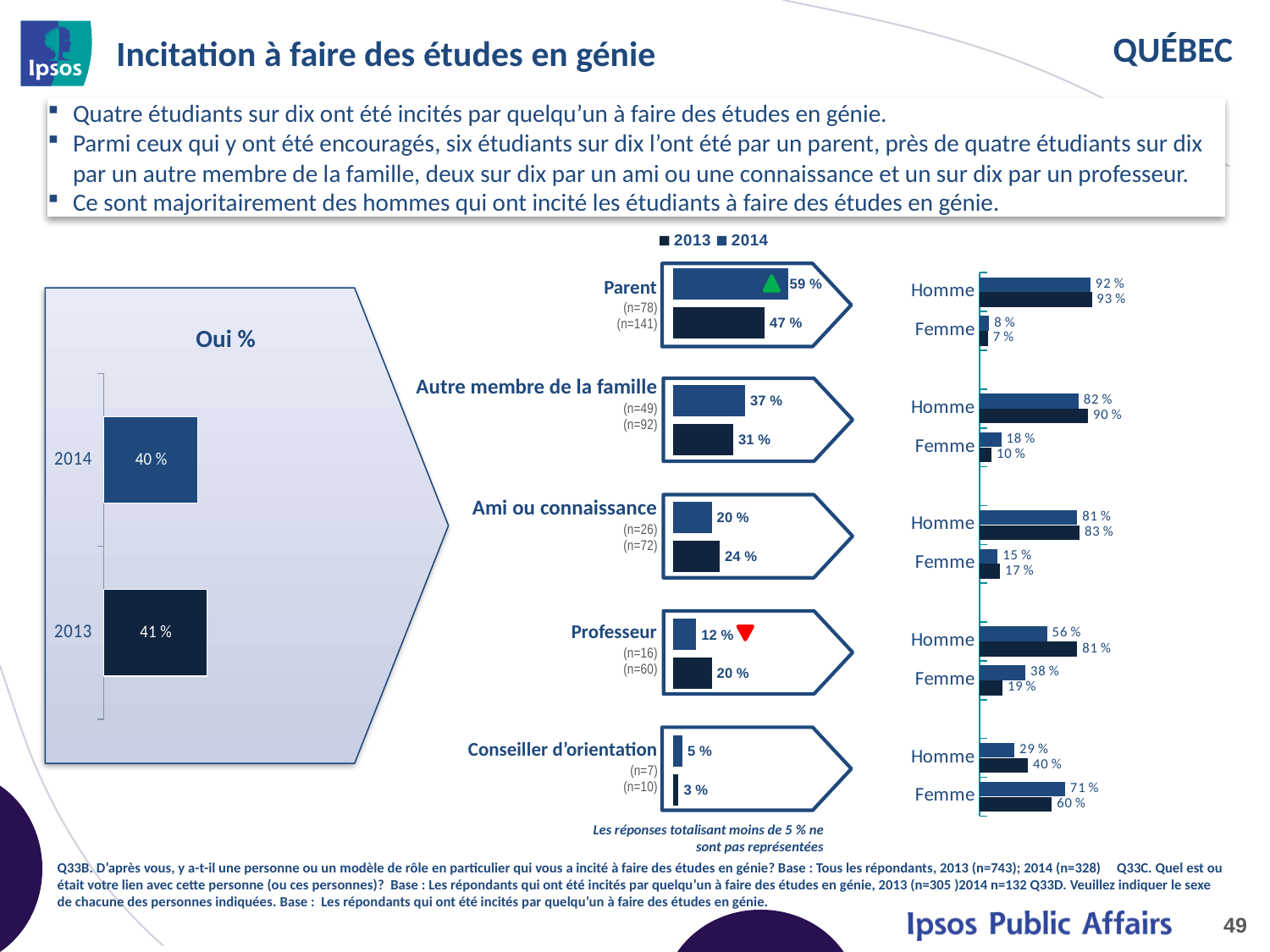
What kind of chart is the 'Oui %' chart on the left? Bar chart In the 'Oui %' chart on the left, which year has the larger value, 2013 or 2014? 2013 How many relationship categories are shown in the middle chart? 5 In the middle chart of relationship categories, which category has the highest value? Parent In the 'Oui %' chart on the left, what is the difference between the 2013 and 2014 values? 1 % How many series does the legend above the middle chart list? 2 What are the two entries in the legend above the middle chart? 2013 and 2014 In the 'Oui %' chart on the left, what is the value for 2013? 41 % In the 'Oui %' chart on the left, what is the value for 2014? 40 % In the middle chart of relationship categories, which category has the lowest values? Conseiller d'orientation In the right-hand Homme/Femme chart, what is the highest value shown for Femme? 71 % In the middle chart, what is the larger of the two values shown for Professeur? 20 %